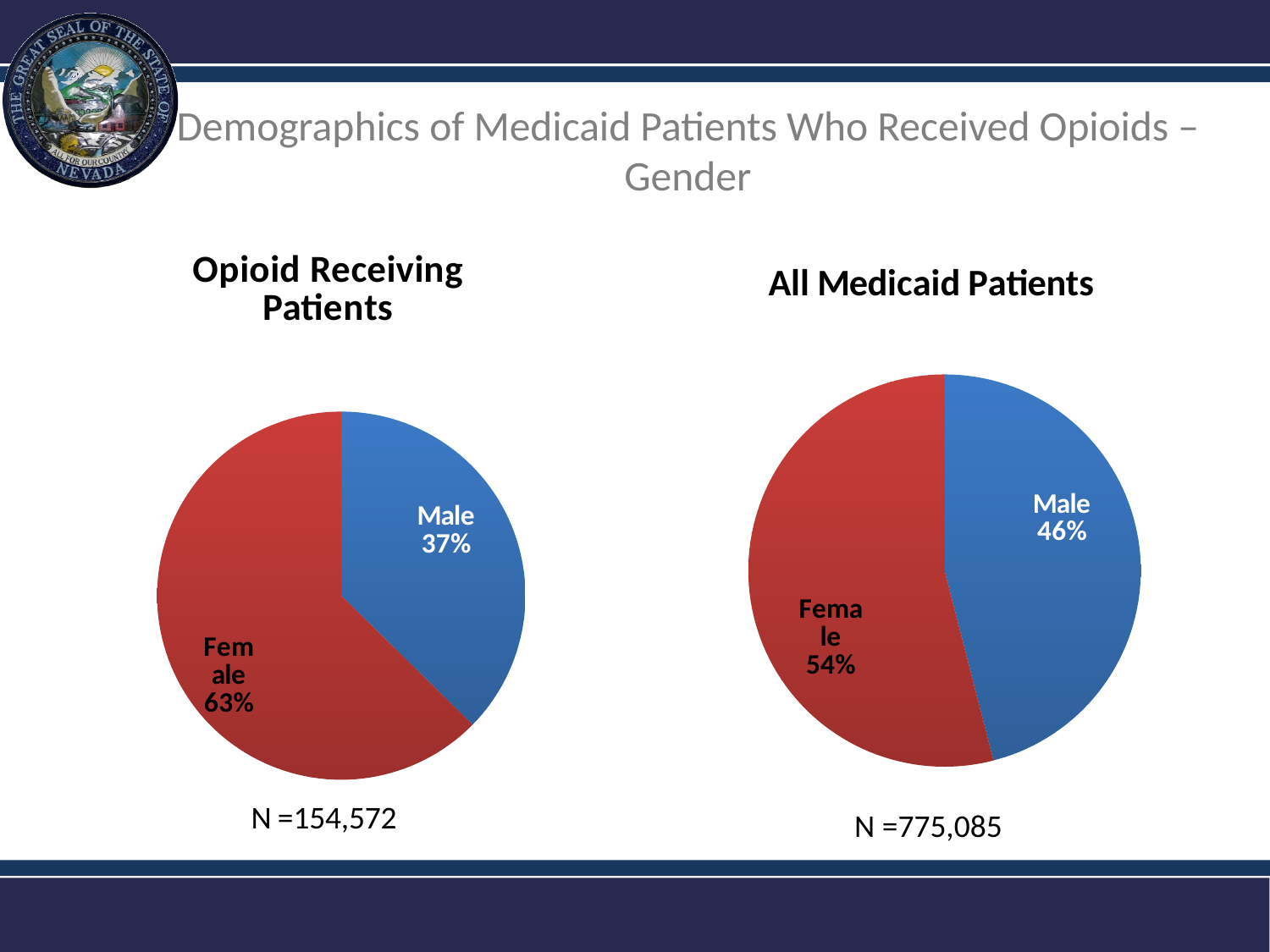
In the 'All Medicaid Patients' chart, what share of patients are Male? 46% In the 'Opioid Receiving Patients' chart, what share of patients are Female? 63% In the 'All Medicaid Patients' chart, what share of patients are Female? 54% In the 'Opioid Receiving Patients' chart, what is the difference between the Female and Male shares? 26 percentage points What is the N value shown below the 'Opioid Receiving Patients' chart? N =154,572 In the 'All Medicaid Patients' chart, which slice is the smallest? Male In the 'Opioid Receiving Patients' chart, which slice is the largest? Female What type of chart is used for 'All Medicaid Patients'? Pie chart Is the Male share larger in the 'Opioid Receiving Patients' chart or in the 'All Medicaid Patients' chart? All Medicaid Patients In the 'All Medicaid Patients' chart, what is the difference between the Female and Male shares? 8 percentage points How many slices does the 'Opioid Receiving Patients' pie chart have? 2 In the 'Opioid Receiving Patients' chart, what share of patients are Male? 37%